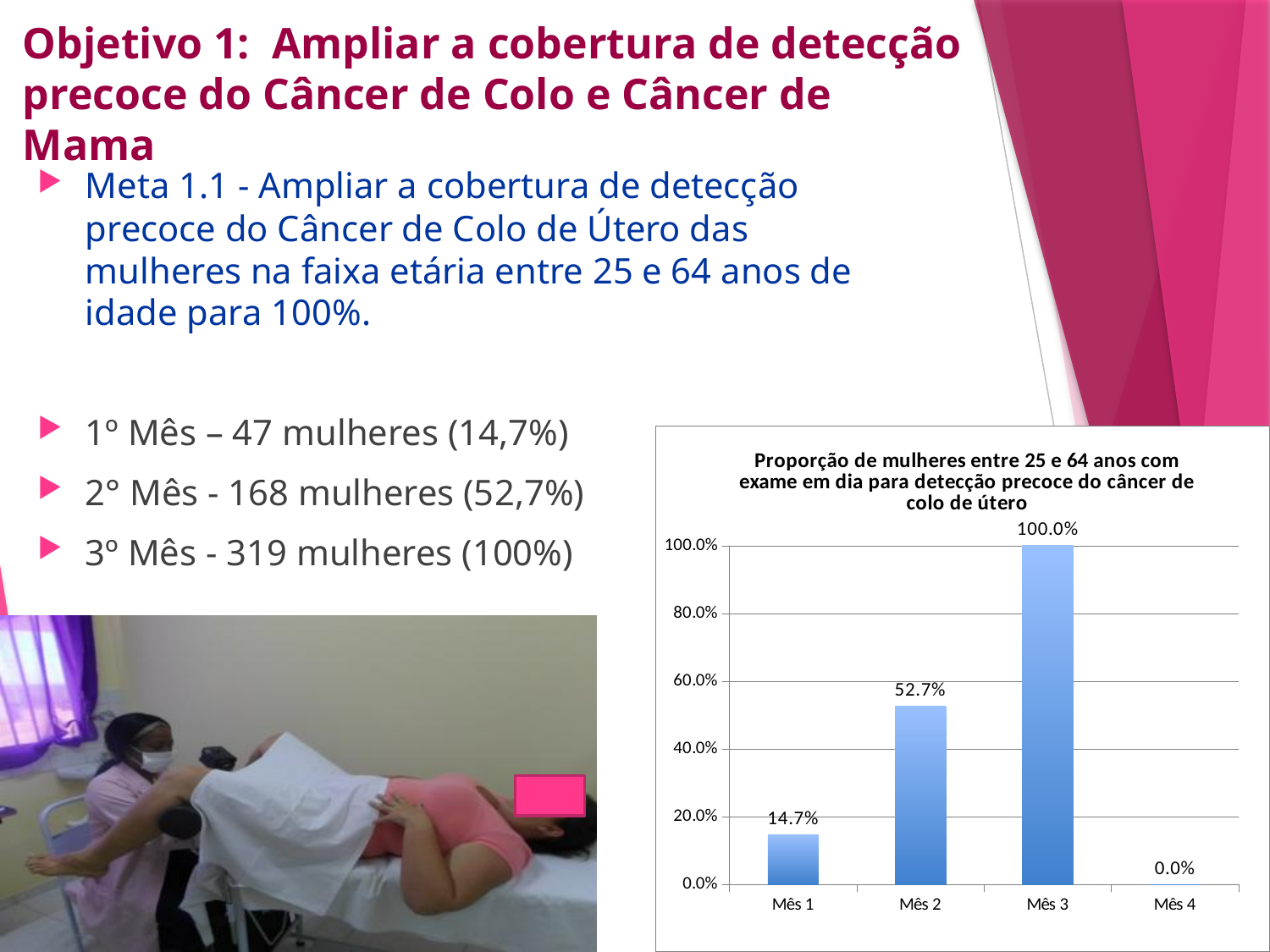
Which month has the lowest value in the chart? Mês 4 What kind of chart is shown on the slide? Bar chart What is the value for Mês 2 in the chart? 52.7% What is the value for Mês 3 in the chart? 100.0% Which is larger, the value for Mês 1 or the value for Mês 2? Mês 2 What is the title of the chart? Proporção de mulheres entre 25 e 64 anos com exame em dia para detecção precoce do câncer de colo de útero How many categories are shown on the x axis of the chart? 4 What is the difference between the values for Mês 3 and Mês 2? 47.3% What is the difference between the values for Mês 2 and Mês 1? 38.0% Which month has the highest value in the chart? Mês 3 What is the value for Mês 4 in the chart? 0.0% What is the value for Mês 1 in the chart? 14.7%